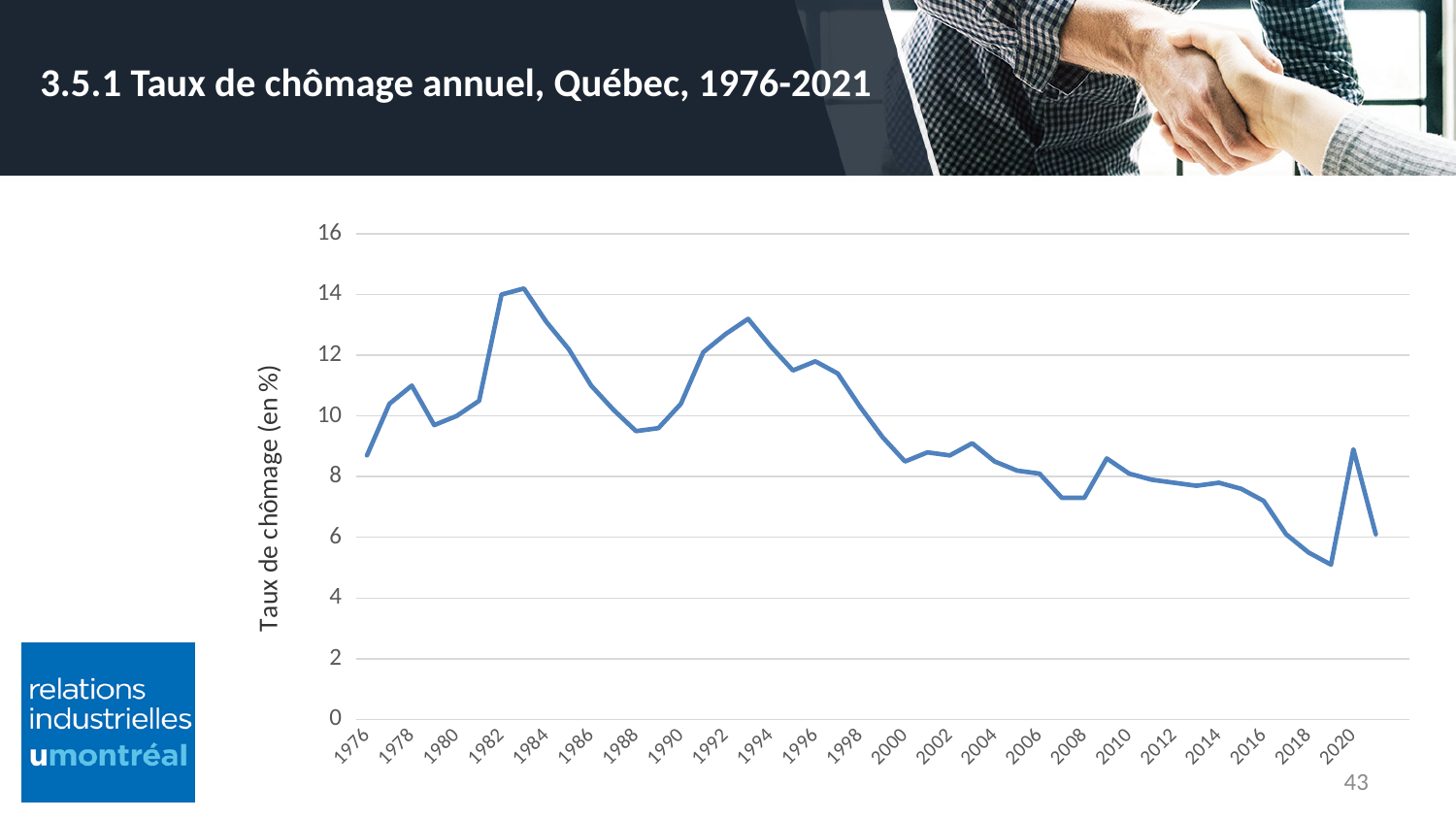
Which year has the higher unemployment rate, 1983 or 1993? 1983 In which year does the unemployment rate reach its lowest point? 2019 What is the label of the vertical axis? Taux de chômage (en %) In which year does the unemployment rate reach its highest point? 1983 What is the title of the chart? 3.5.1 Taux de chômage annuel, Québec, 1976-2021 Is the unemployment rate in 1993 greater or less than 12? greater Overall, does the unemployment rate rise or fall from 1976 to 2021? fall What kind of chart is shown on the slide? line chart Is the unemployment rate in 1976 greater or less than 8? greater Which year has the higher unemployment rate, 2019 or 2020? 2020 Is the unemployment rate in 2019 greater or less than 6? less